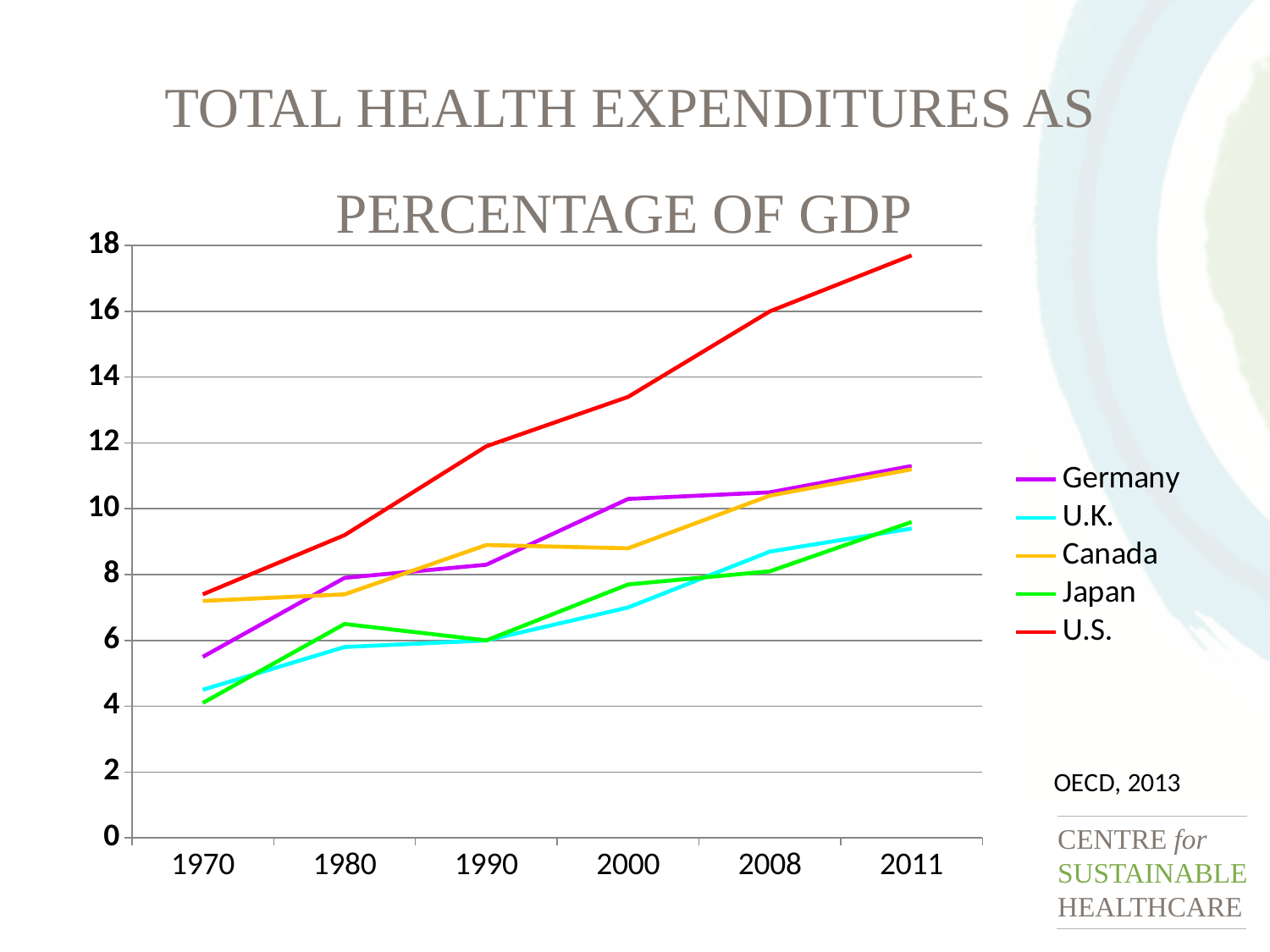
What colour is the line for the U.S.? red How many series does the legend list? 5 Is the value for the U.S. in 2011 greater or less than 16? greater What kind of chart is shown on the slide? line chart What source is cited for the chart data? OECD, 2013 Which country has the highest health expenditure as a percentage of GDP in 2011? U.S. Is the value for Germany in 1970 greater or less than 6? less Which country has the lowest value in 2000? U.K. How many years are shown along the x axis? 6 In 2000, which is larger, the value for Germany or the value for Canada? Germany Is the value for the U.K. in 1990 greater or less than 8? less Does the U.S. line rise or fall from 1970 to 2011? rise